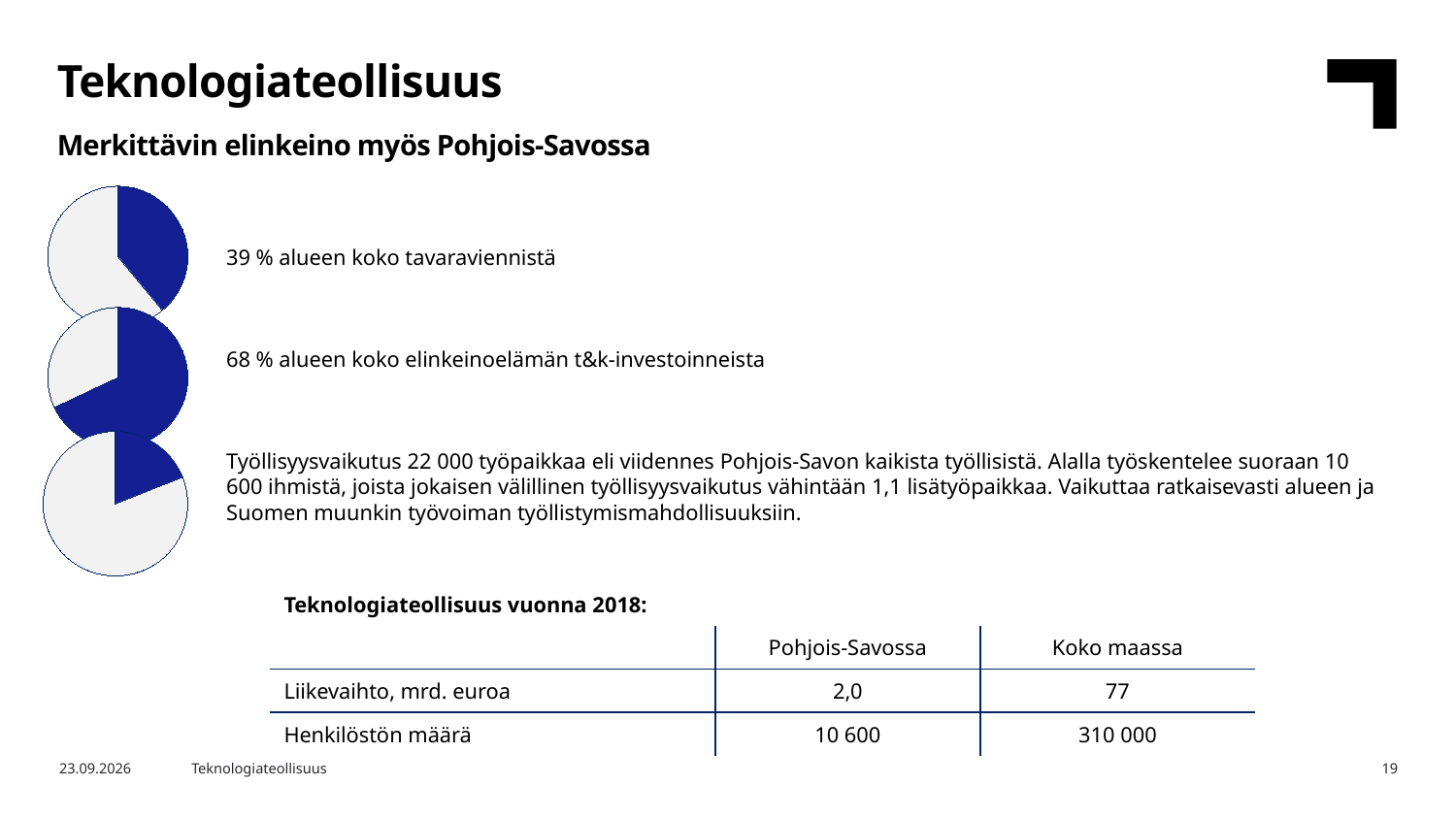
How many pie charts are on the slide? 3 What kind of charts are shown on the left side of the slide? Pie charts What colour is the highlighted slice in the pie charts? Dark blue Is the highlighted slice in the middle pie chart greater or less than 50% of the pie? greater In the middle pie chart, what share of the region's business R&D investments does the highlighted slice represent? 68 % Is the highlighted slice in the top pie chart larger or smaller than the highlighted slice in the middle pie chart? Smaller What is the difference in percentage points between the share shown for the middle pie chart (68 %) and the top pie chart (39 %)? 29 percentage points Which pie chart has the largest highlighted (blue) slice: the top, middle or bottom one? Middle Which pie chart has the smallest highlighted (blue) slice: the top, middle or bottom one? Bottom In the top pie chart, what share of the region's total goods exports does the highlighted slice represent? 39 % How many slices does each pie chart have? 2 Is the highlighted slice in the bottom pie chart greater or less than 50% of the pie? less